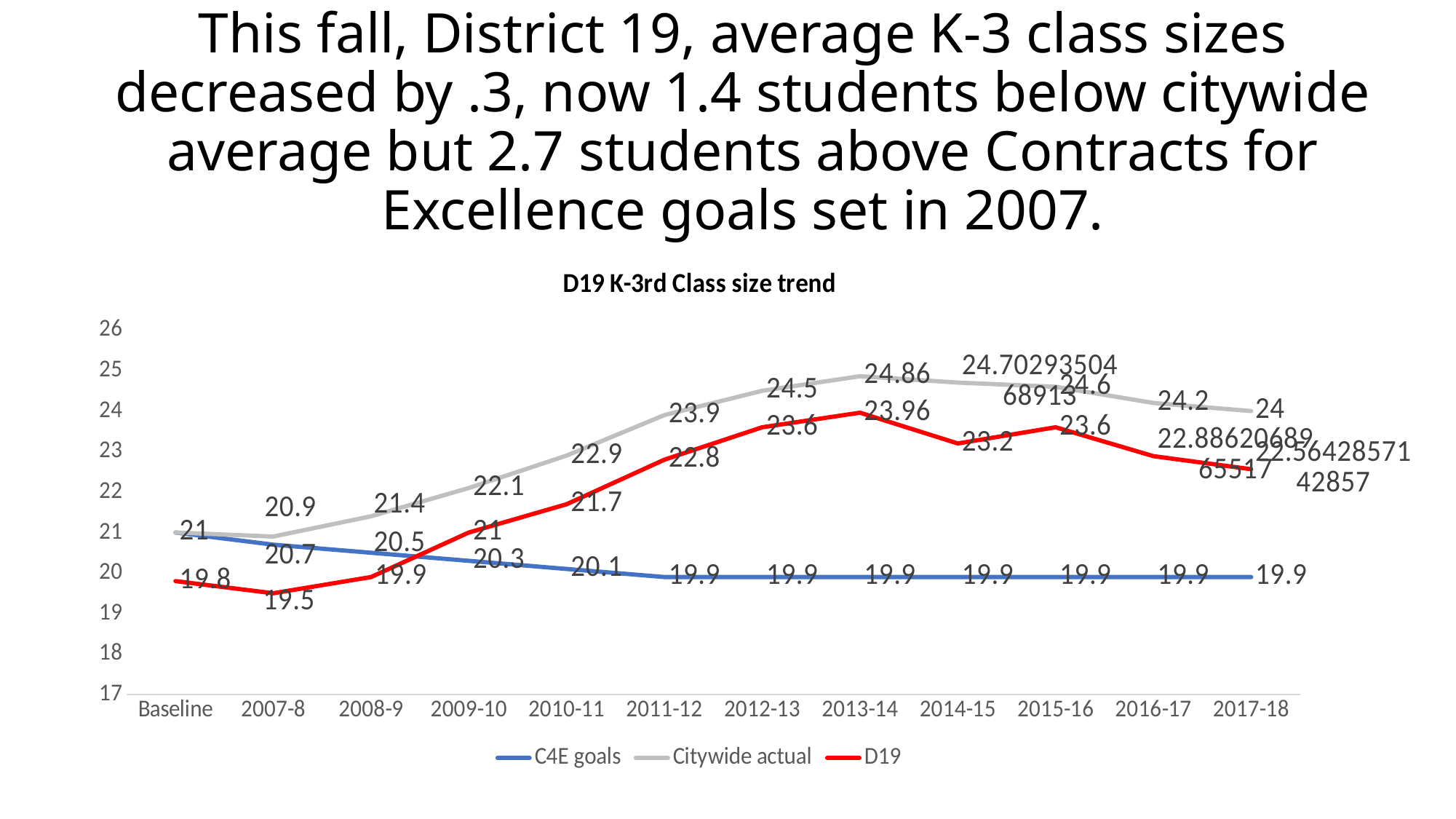
What is the C4E goals value for 2008-9? 20.5 How many categories are shown on the x axis? 12 What is the D19 value for 2011-12? 22.8 In 2010-11, which is larger: Citywide actual or D19? Citywide actual How many series does the legend list? 3 What is the difference between the Citywide actual and D19 values in 2012-13? 0.9 In which year is the D19 series at its lowest? 2007-8 In which year is the Citywide actual series at its highest? 2013-14 Do the C4E goals values rise or fall from Baseline to 2011-12? fall Is the D19 value for 2017-18 greater or less than 23? less What kind of chart is shown on the slide? line chart What is the Citywide actual value for 2013-14? 24.86